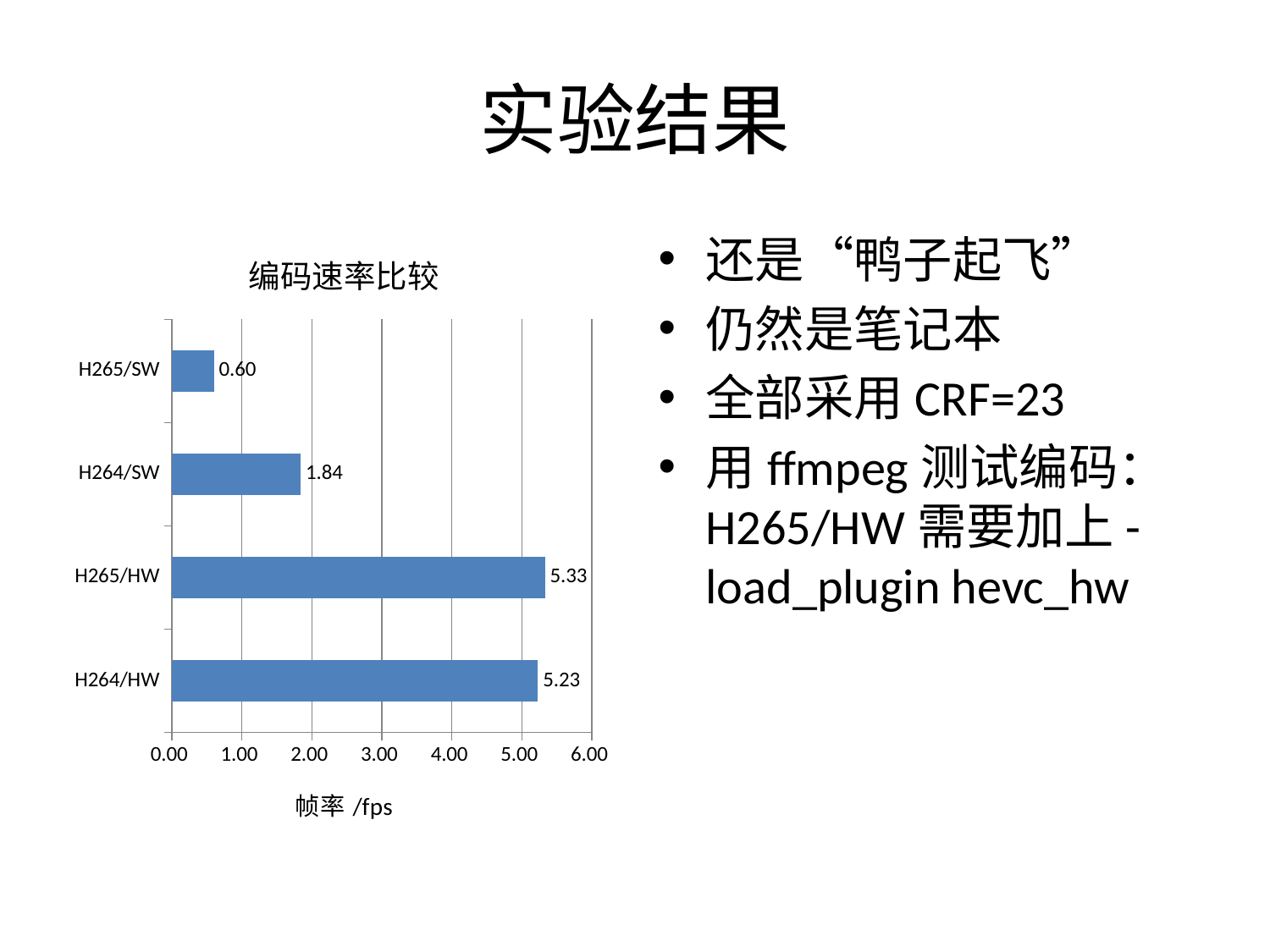
What is the value for H265/HW? 5.33 What is the value for H264/HW? 5.23 What is the difference between the values for H264/SW and H265/SW? 1.24 Which category has the lowest value? H265/SW How many categories are shown in the chart? 4 What kind of chart is shown on the slide? Bar chart What is the value for H265/SW? 0.60 What is the title of the chart? 编码速率比较 What is the value for H264/SW? 1.84 What is the difference between the values for H265/HW and H264/HW? 0.10 Which is larger, the value for H264/SW or the value for H265/SW? H264/SW Which category has the highest value? H265/HW